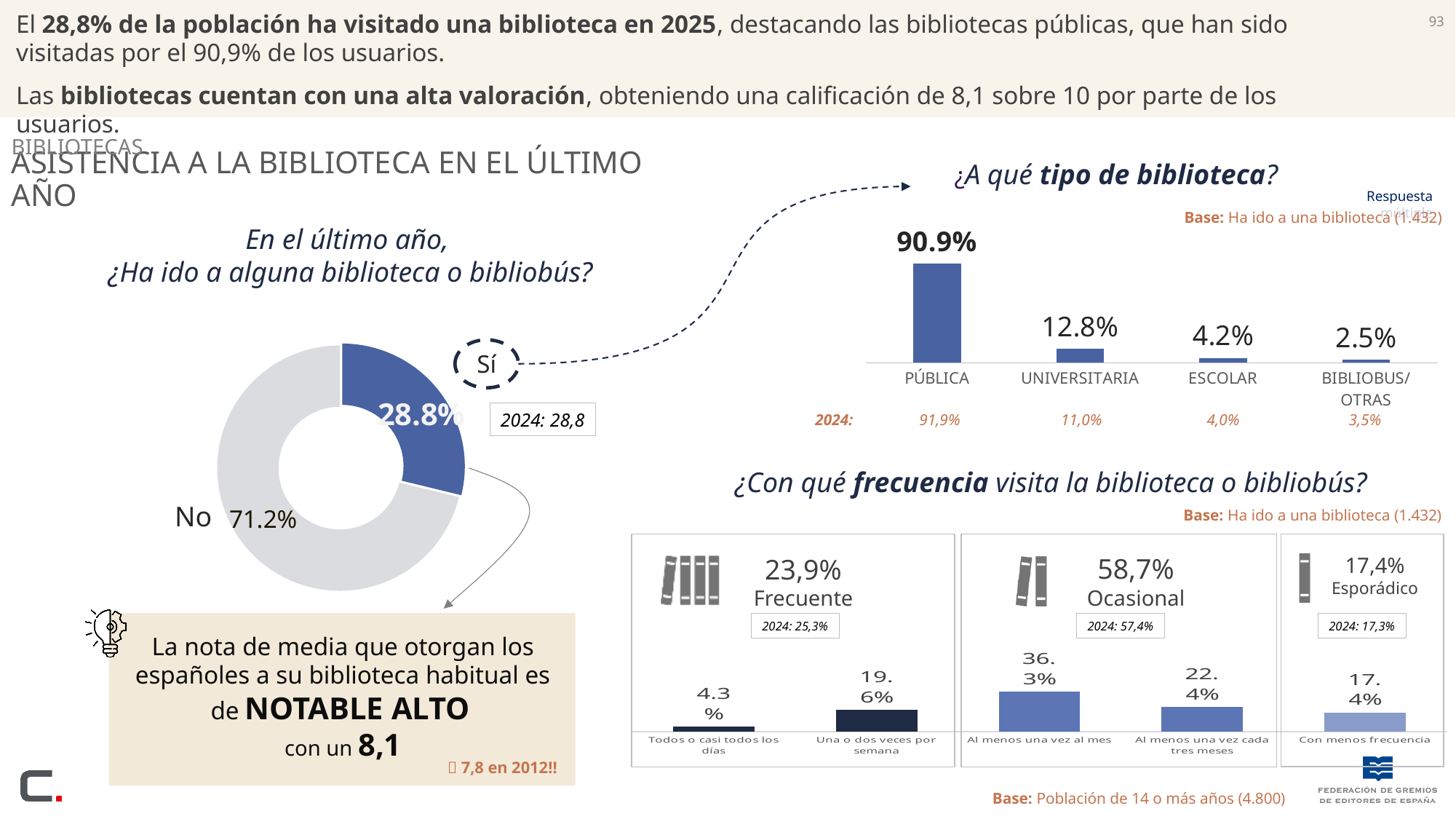
In the bar chart '¿A qué tipo de biblioteca?', what is the value for PÚBLICA? 90.9% In the bar chart '¿A qué tipo de biblioteca?', what kind of chart is it? Bar chart In the donut chart '¿Ha ido a alguna biblioteca o bibliobús?', what percentage answered No? 71.2% In the frequency chart '¿Con qué frecuencia visita la biblioteca o bibliobús?', what is the value for 'Con menos frecuencia'? 17.4% In the frequency chart '¿Con qué frecuencia visita la biblioteca o bibliobús?', which is larger: 'Una o dos veces por semana' or 'Todos o casi todos los días'? Una o dos veces por semana In the frequency chart '¿Con qué frecuencia visita la biblioteca o bibliobús?', what is the value for 'Al menos una vez al mes'? 36.3% In the bar chart '¿A qué tipo de biblioteca?', what is the difference between ESCOLAR and BIBLIOBUS/OTRAS? 1.7% In the bar chart '¿A qué tipo de biblioteca?', which category has the lowest value? BIBLIOBUS/OTRAS In the bar chart '¿A qué tipo de biblioteca?', how many categories are shown? 4 In the donut chart '¿Ha ido a alguna biblioteca o bibliobús?', what percentage answered Sí? 28.8% What kind of chart is used for '¿Ha ido a alguna biblioteca o bibliobús?'? Donut chart In the bar chart '¿A qué tipo de biblioteca?', what is the value for UNIVERSITARIA? 12.8%